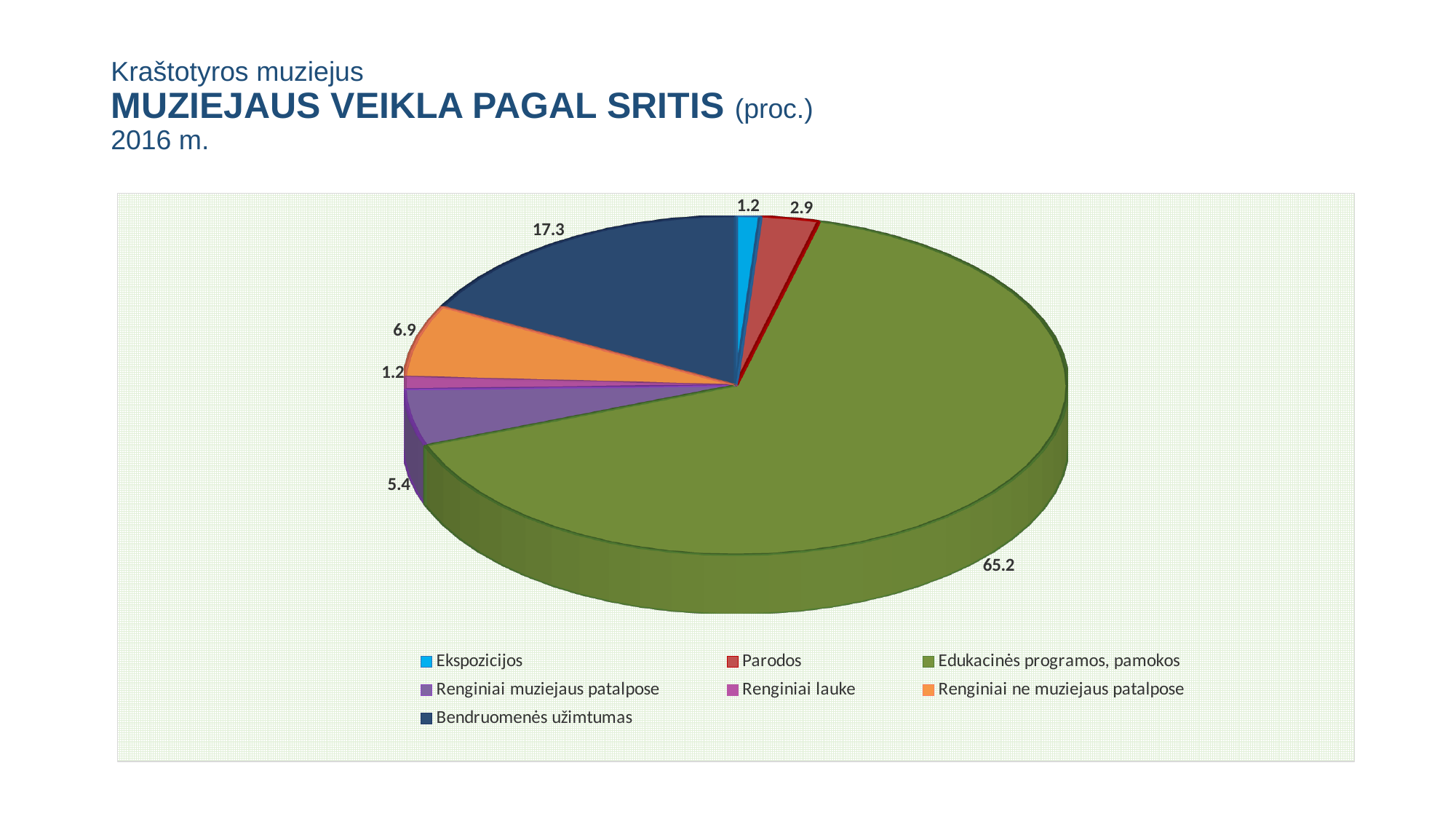
What is the value for Parodos? 2.9 What kind of chart is shown on the slide? pie chart What is the difference between the values for Renginiai ne muziejaus patalpose and Parodos? 4.0 Which colour represents Bendruomenės užimtumas in the legend? dark blue What is the difference between the values for Bendruomenės užimtumas and Renginiai muziejaus patalpose? 11.9 Which category has the largest share of the pie? Edukacinės programos, pamokos What is the value for Renginiai muziejaus patalpose? 5.4 What is the value for Renginiai ne muziejaus patalpose? 6.9 Which is larger, Bendruomenės užimtumas or Renginiai ne muziejaus patalpose? Bendruomenės užimtumas How many categories does the pie chart show? 7 What is the value for Edukacinės programos, pamokos? 65.2 What is the value for Bendruomenės užimtumas? 17.3